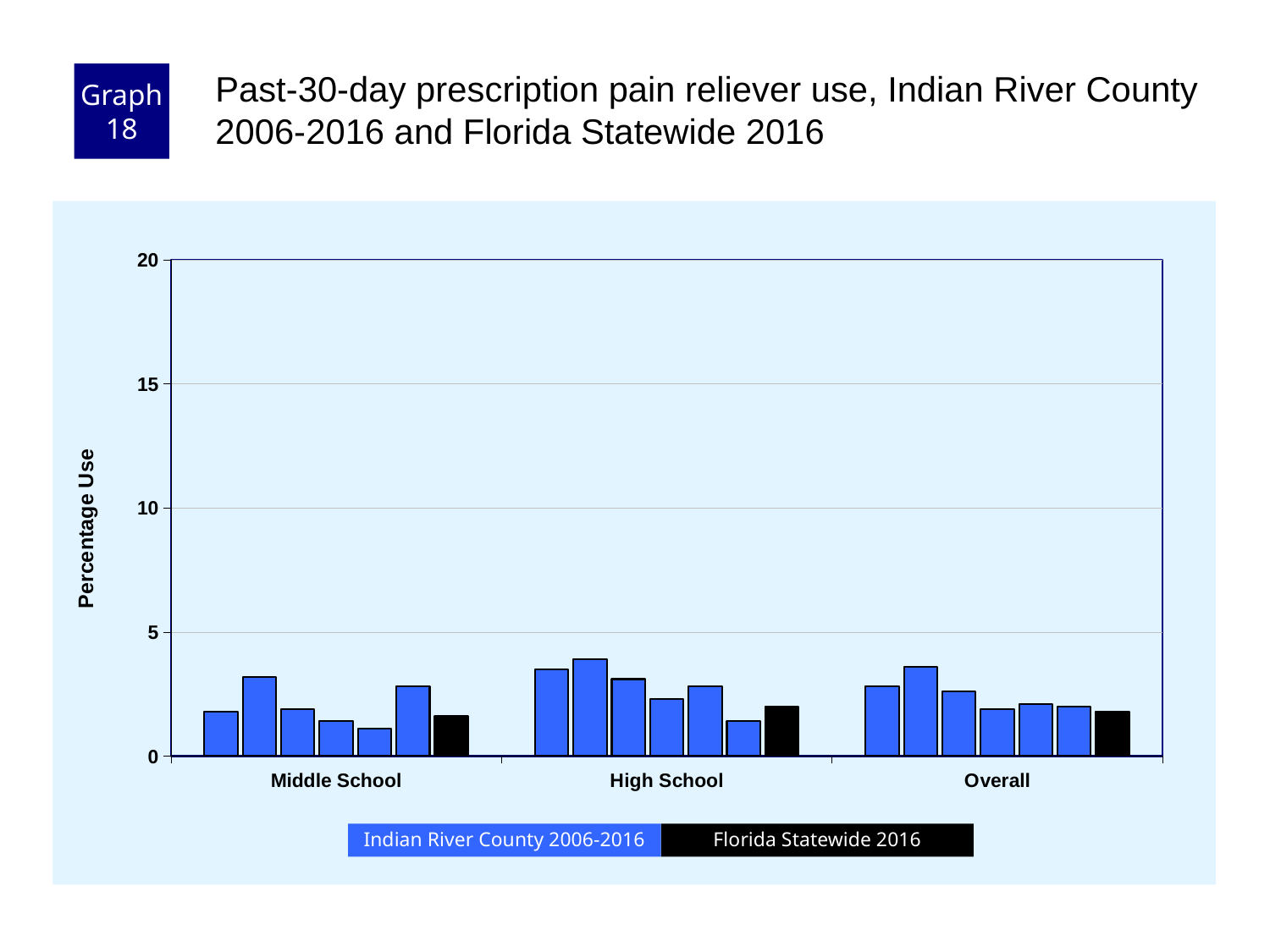
Is the Florida Statewide 2016 value for Overall greater or less than 5? less How many categories are shown along the x axis? 3 For Overall, which is larger: the Florida Statewide 2016 bar or the tallest Indian River County 2006-2016 bar? the tallest Indian River County 2006-2016 bar What kind of chart is shown on the slide? bar chart Is the tallest Indian River County 2006-2016 bar for Middle School greater or less than 5? less How many series does the legend list? 2 What is the label of the y axis? Percentage Use For Middle School, which is larger: the Florida Statewide 2016 bar or the tallest Indian River County 2006-2016 bar? the tallest Indian River County 2006-2016 bar Which colour represents the Florida Statewide 2016 series? black For High School, which is larger: the Florida Statewide 2016 bar or the tallest Indian River County 2006-2016 bar? the tallest Indian River County 2006-2016 bar Is the Florida Statewide 2016 value for High School greater or less than 5? less